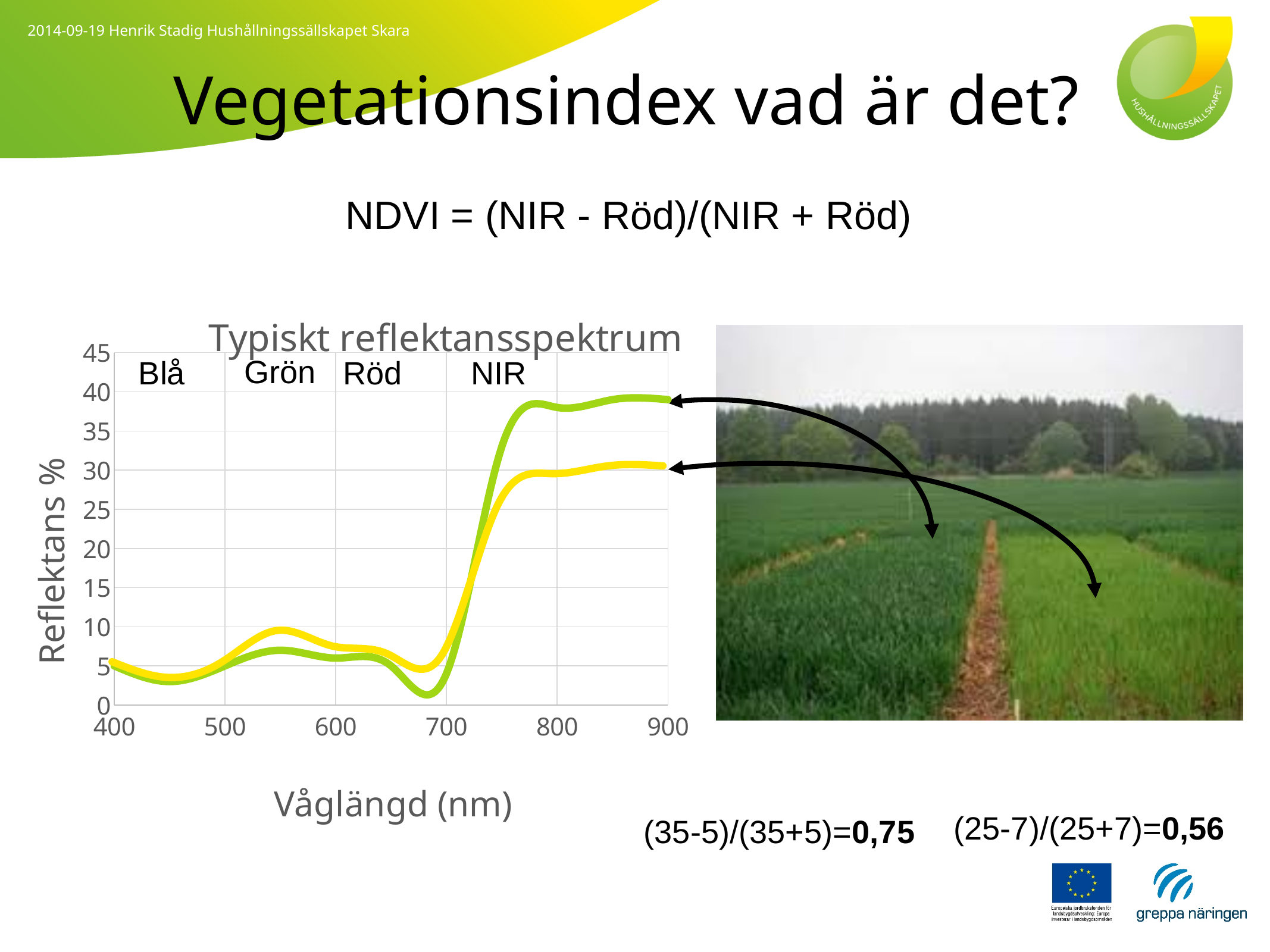
Do the lines rise or fall between 700 nm and 800 nm? rise What is the label on the vertical axis of the chart? Reflektans % Is the lowest point of the green line, near 680 nm, greater or less than 5? less Is the value of the green line at 550 nm greater or less than 10? less What kind of chart is shown on the slide? line chart Is the value of the yellow line at 900 nm greater or less than 40? less At 900 nm, which line has the higher reflectance, the green line or the yellow line? the green line What is the highest value shown on the y axis of the chart? 45 How many lines are plotted in the chart? 2 How many tick labels are shown on the x axis of the chart? 6 What is the title of the chart? Typiskt reflektansspektrum